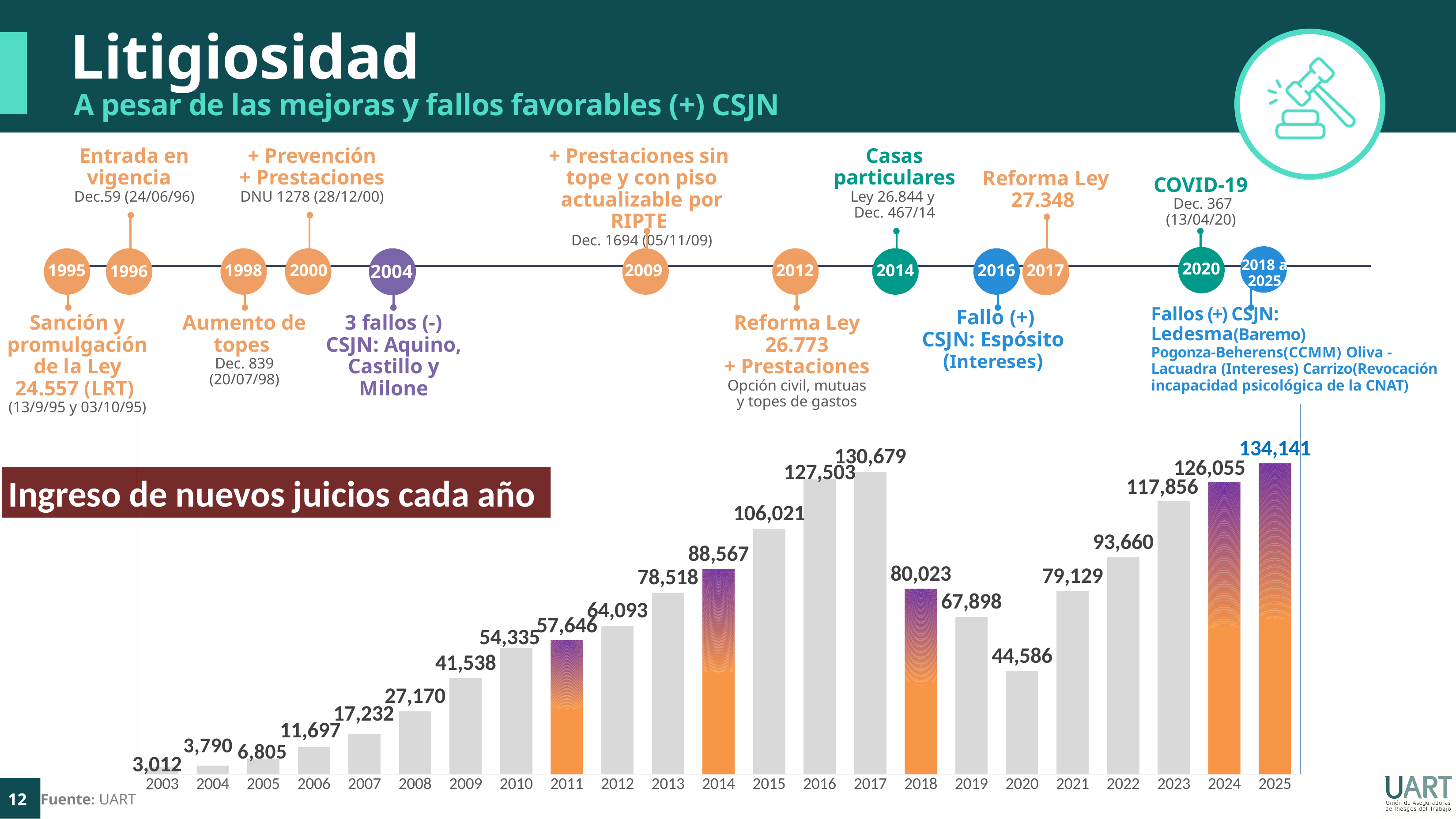
In the "Ingreso de nuevos juicios cada año" chart, do the values rise or fall from 2003 to 2017? Rise What is the title shown on the bar chart at the bottom of the slide? Ingreso de nuevos juicios cada año In the "Ingreso de nuevos juicios cada año" chart, what is the difference between the values for 2017 and 2018? 50,656 In the "Ingreso de nuevos juicios cada año" chart, which is larger, the value for 2016 or the value for 2023? 2016 Which year has the highest value in the "Ingreso de nuevos juicios cada año" chart? 2025 What is the value for 2020 in the "Ingreso de nuevos juicios cada año" chart? 44,586 How many years (bars) are shown in the "Ingreso de nuevos juicios cada año" chart? 23 What is the value for 2011 in the "Ingreso de nuevos juicios cada año" chart? 57,646 What kind of chart is shown under the heading "Ingreso de nuevos juicios cada año"? Bar chart In the "Ingreso de nuevos juicios cada año" chart, what is the difference between the values for 2025 and 2024? 8,086 Which year has the lowest value in the "Ingreso de nuevos juicios cada año" chart? 2003 What is the value for 2017 in the "Ingreso de nuevos juicios cada año" chart? 130,679